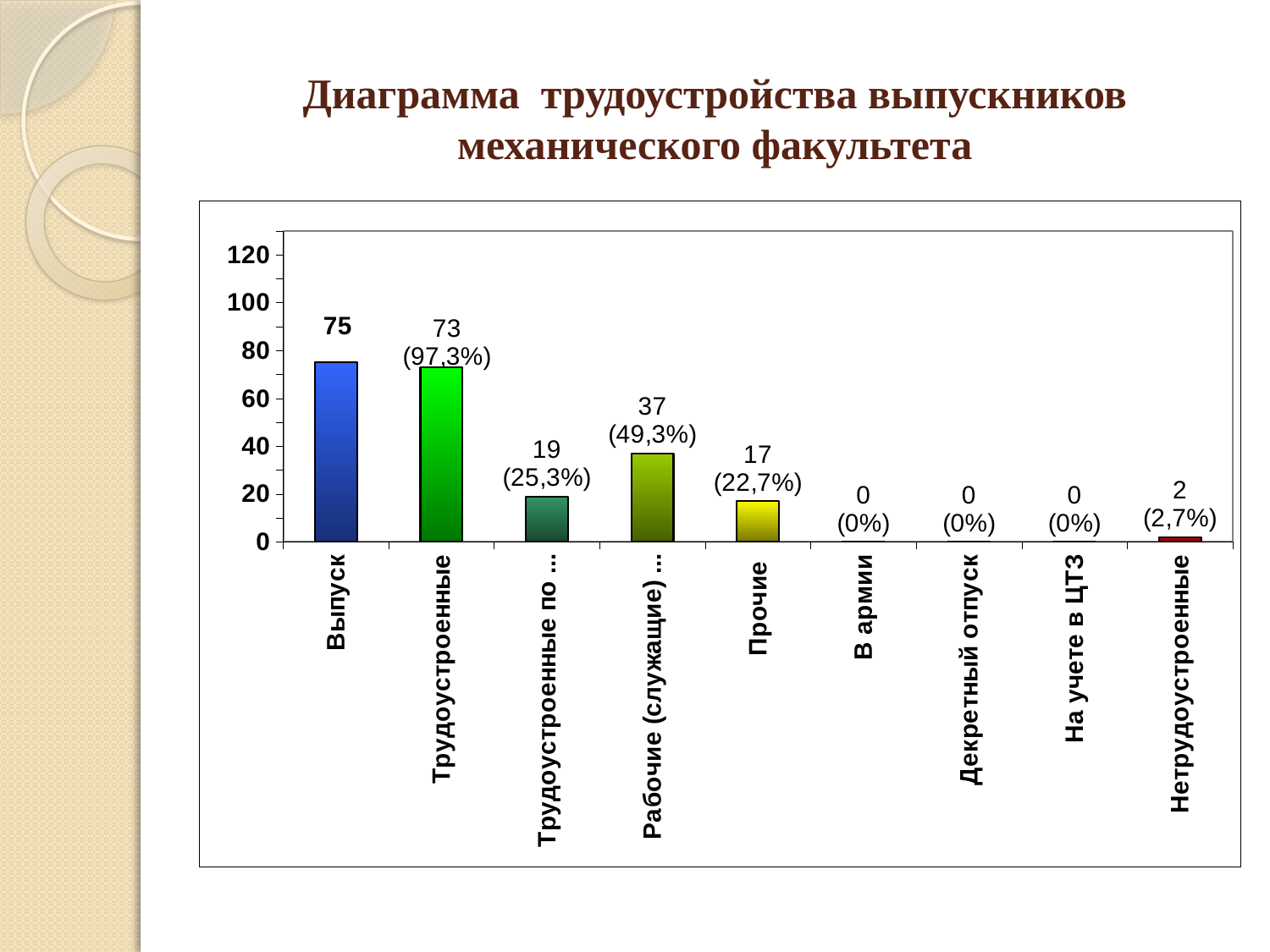
How many categories have a value of 0? 3 What percentage is shown in parentheses for Трудоустроенные? 97,3% What is the title of the slide? Диаграмма трудоустройства выпускников механического факультета What is the value shown for Выпуск? 75 What value is printed above the bar for Трудоустроенные? 73 Which is larger, the value for Прочие or the value for Нетрудоустроенные? Прочие What is the value shown for Прочие? 17 How many categories are shown on the x axis? 9 What value and percentage are shown for Нетрудоустроенные? 2 (2,7%) What kind of chart is shown on the slide? Bar chart Which category has the highest value? Выпуск What is the difference between the values for Выпуск and Трудоустроенные? 2